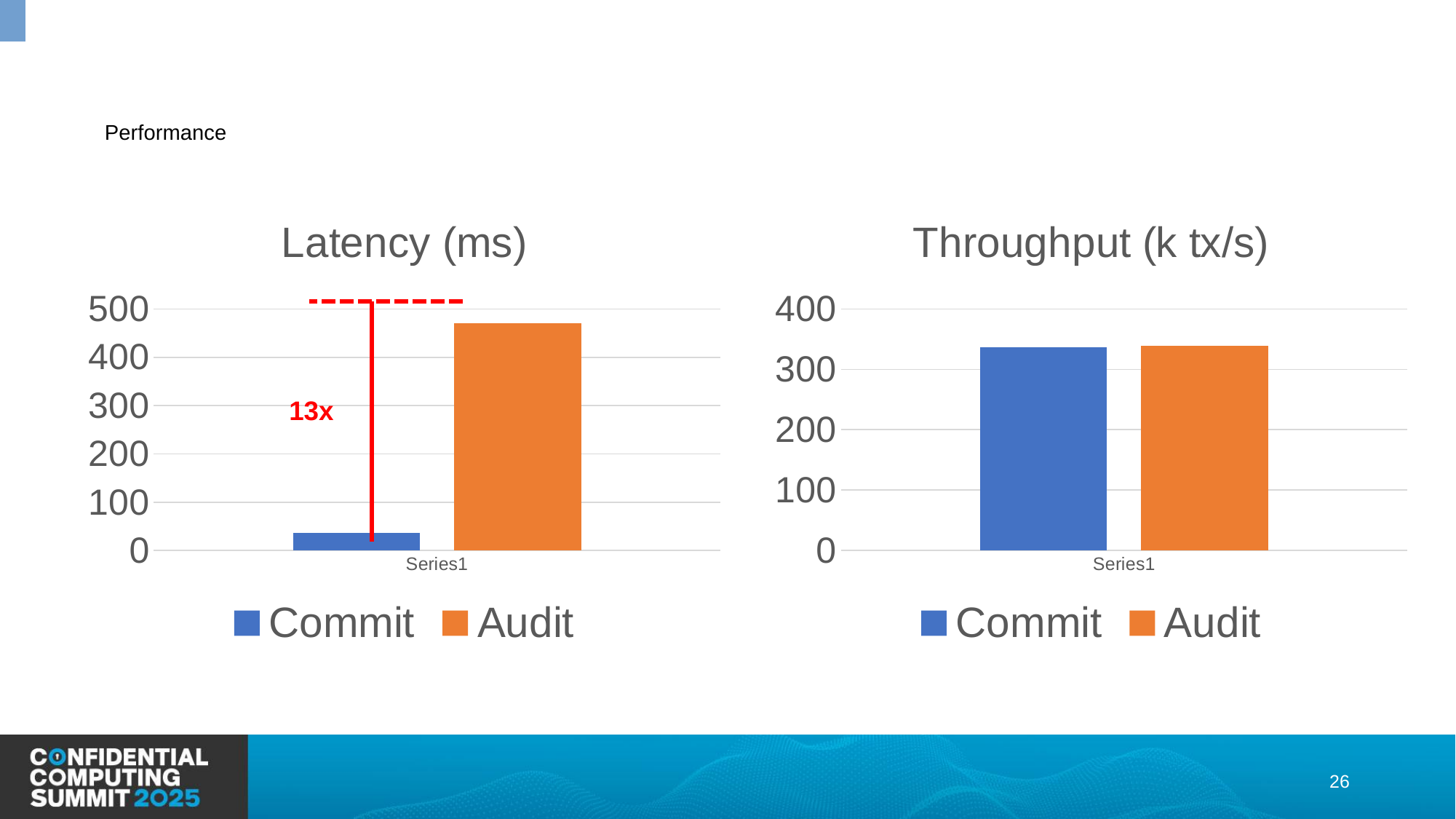
What kind of chart is the Throughput (k tx/s) chart? bar chart In the Throughput (k tx/s) chart, is the value for Commit greater or less than 300? greater What kind of chart is the Latency (ms) chart? bar chart How many series does the legend of the Latency (ms) chart list? 2 In the Throughput (k tx/s) chart, is the value for Audit greater or less than 400? less What ratio is annotated in red on the Latency (ms) chart? 13x In the Latency (ms) chart, is the value for Commit greater or less than 100? less In the Latency (ms) chart, which series has the lowest value? Commit In the Latency (ms) chart, which series has the highest value? Audit How many series does the legend of the Throughput (k tx/s) chart list? 2 In the Latency (ms) chart, which series is larger, Commit or Audit? Audit